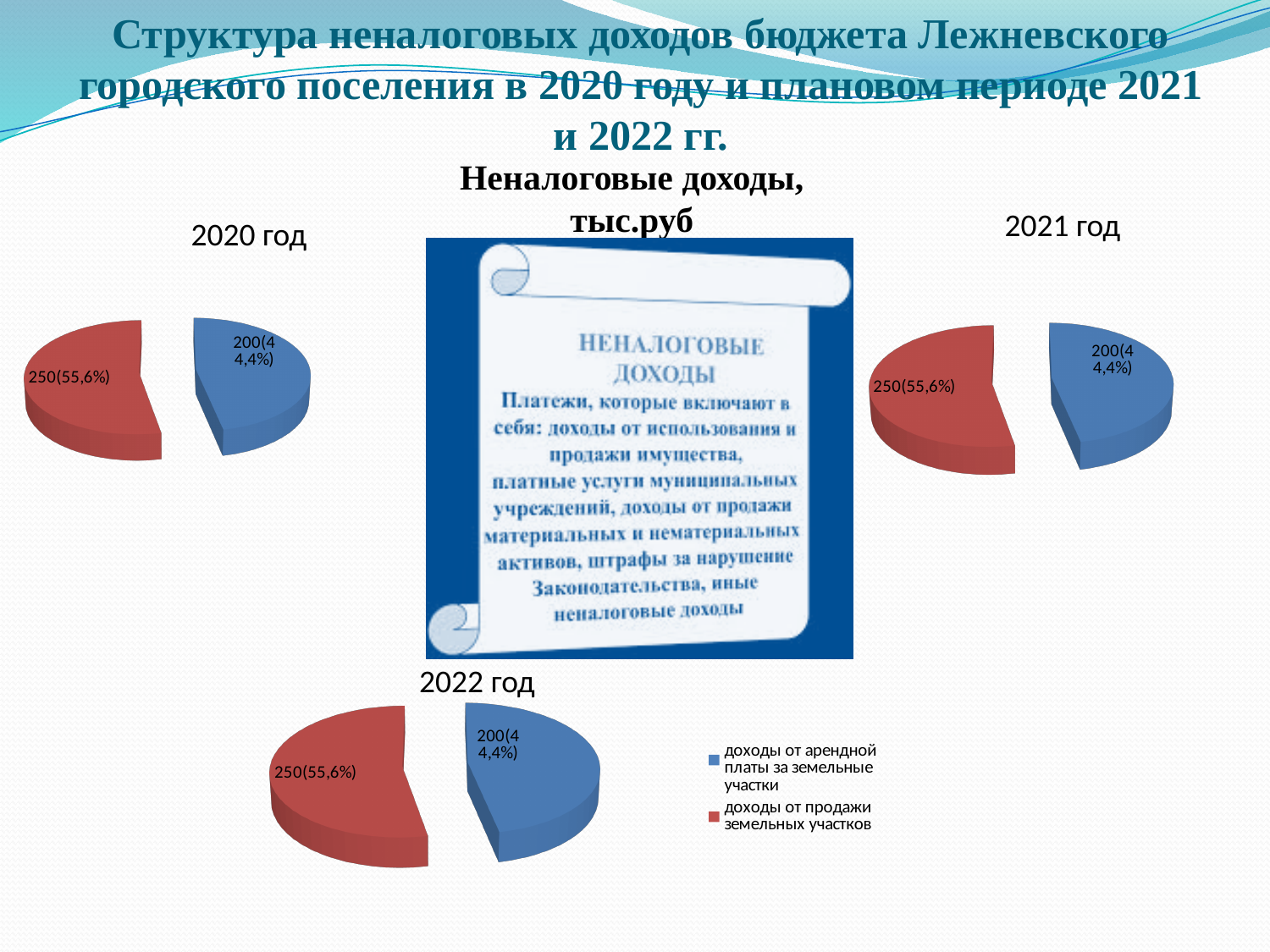
In the 2020 год chart, what is the value for доходы от продажи земельных участков? 250 In the 2022 год chart, what share of the pie is доходы от арендной платы за земельные участки? 44,4% In the 2021 год chart, which category has the smallest slice? доходы от арендной платы за земельные участки How many entries does the legend list? 2 In the 2022 год chart, which is larger: доходы от продажи земельных участков or доходы от арендной платы за земельные участки? доходы от продажи земельных участков How many slices does the 2021 год pie chart have? 2 In the 2020 год chart, what is the value for доходы от арендной платы за земельные участки? 200 What colour represents доходы от продажи земельных участков in the pie charts? red In the 2020 год chart, what is the difference between the value for доходы от продажи земельных участков and the value for доходы от арендной платы за земельные участки? 50 In the 2021 год chart, what share of the pie is доходы от продажи земельных участков? 55,6% What type of chart is used for the 2020 год chart? pie chart In the 2022 год chart, which category has the largest slice? доходы от продажи земельных участков